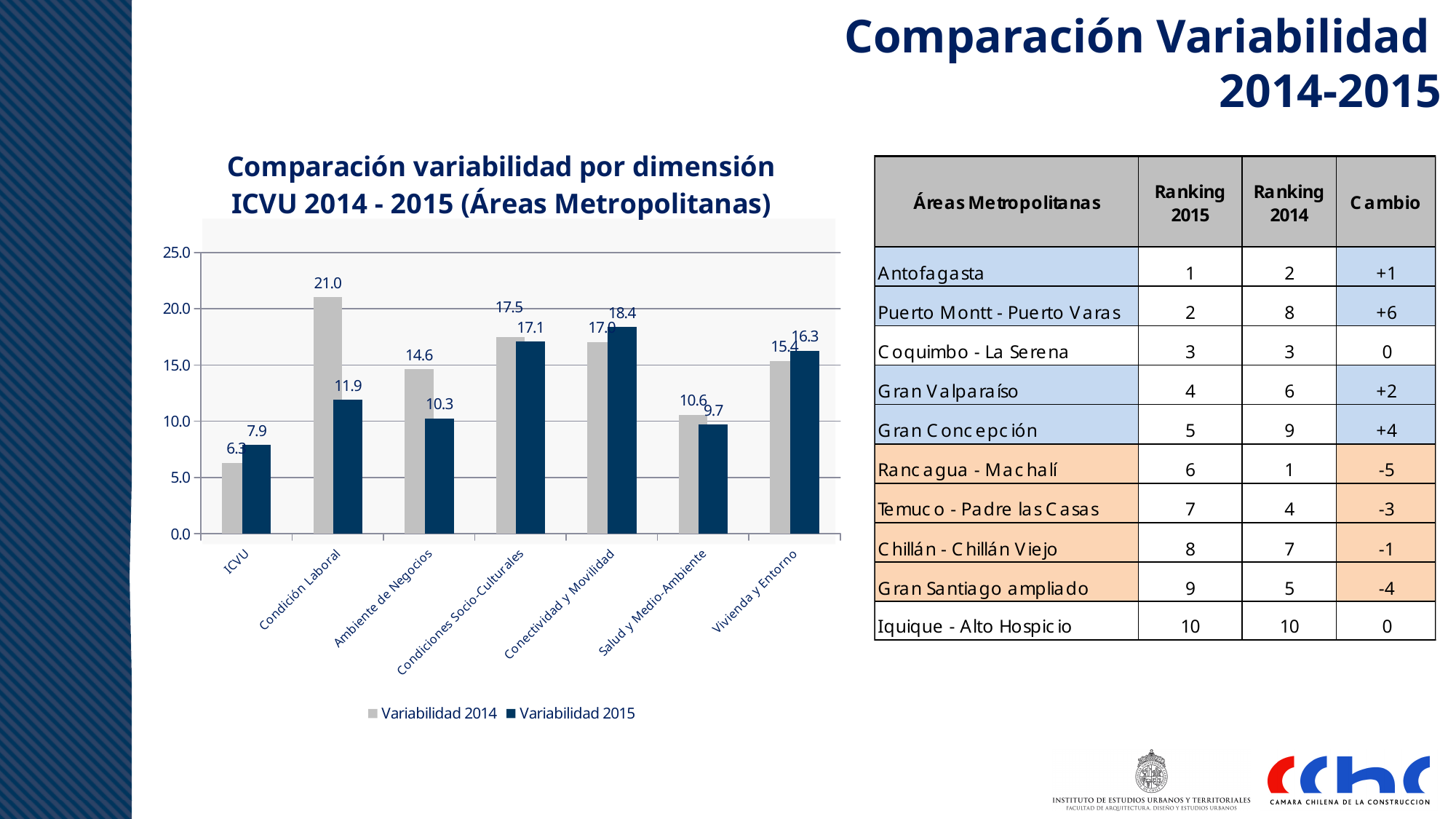
In the chart 'Comparación variabilidad por dimensión ICVU 2014 - 2015', what is the Variabilidad 2014 value for Condición Laboral? 21.0 In the chart, which dimension has the highest Variabilidad 2014 value? Condición Laboral In the chart, what is the Variabilidad 2014 value for Salud y Medio-Ambiente? 10.6 How many series does the chart's legend list? 2 What kind of chart is shown on the slide? Bar chart In the chart, what is the Variabilidad 2015 value for Conectividad y Movilidad? 18.4 In the chart, for Vivienda y Entorno, which is larger: Variabilidad 2014 or Variabilidad 2015? Variabilidad 2015 In the chart, which dimension has the highest Variabilidad 2015 value? Conectividad y Movilidad How many dimensions (categories) are shown on the x axis of the chart? 7 In the chart, what is the difference between the Variabilidad 2014 and Variabilidad 2015 values for Condición Laboral? 9.1 In the chart, which dimension has the lowest Variabilidad 2015 value? ICVU In the chart, is the Variabilidad 2015 value for Ambiente de Negocios greater or less than 15.0? less